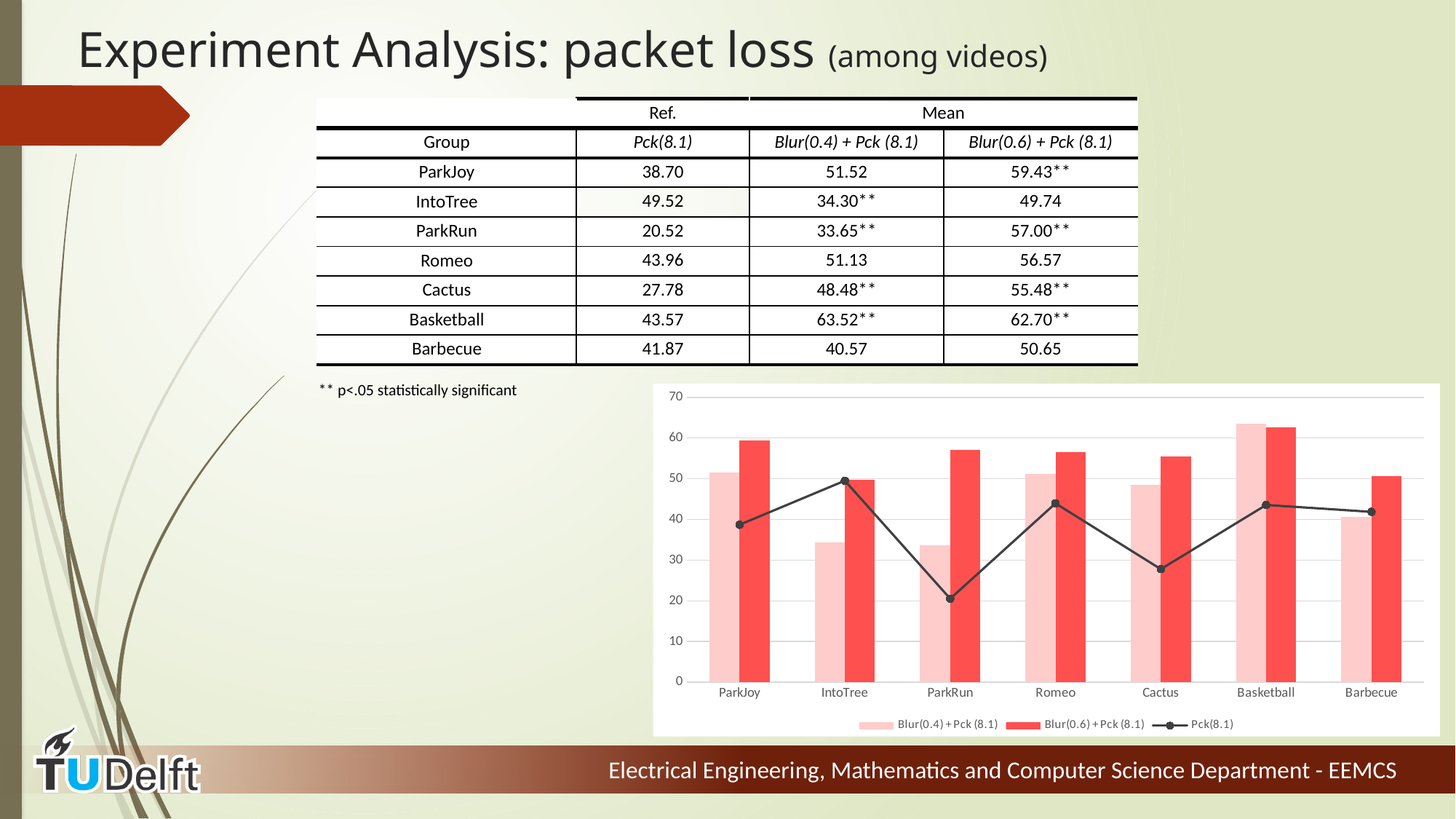
For IntoTree, which is larger: Pck(8.1) or Blur(0.4) + Pck (8.1)? Pck(8.1) Which series is drawn as a line with markers in the chart? Pck(8.1) Which group has the highest Blur(0.4) + Pck (8.1) value in the chart? Basketball Which group has the lowest Pck(8.1) value in the chart? ParkRun Is the Blur(0.4) + Pck (8.1) value for IntoTree greater or less than 40? less How many series does the chart legend list? 3 For Barbecue, which is larger: Blur(0.4) + Pck (8.1) or Blur(0.6) + Pck (8.1)? Blur(0.6) + Pck (8.1) Does the Pck(8.1) line rise or fall from Cactus to Basketball? rise Which group has the highest Blur(0.6) + Pck (8.1) value in the chart? Basketball What kind of chart is shown on the slide? bar chart (with a line series) How many video groups are shown along the x axis of the chart? 7 Is the Blur(0.6) + Pck (8.1) value for ParkRun greater or less than 50? greater